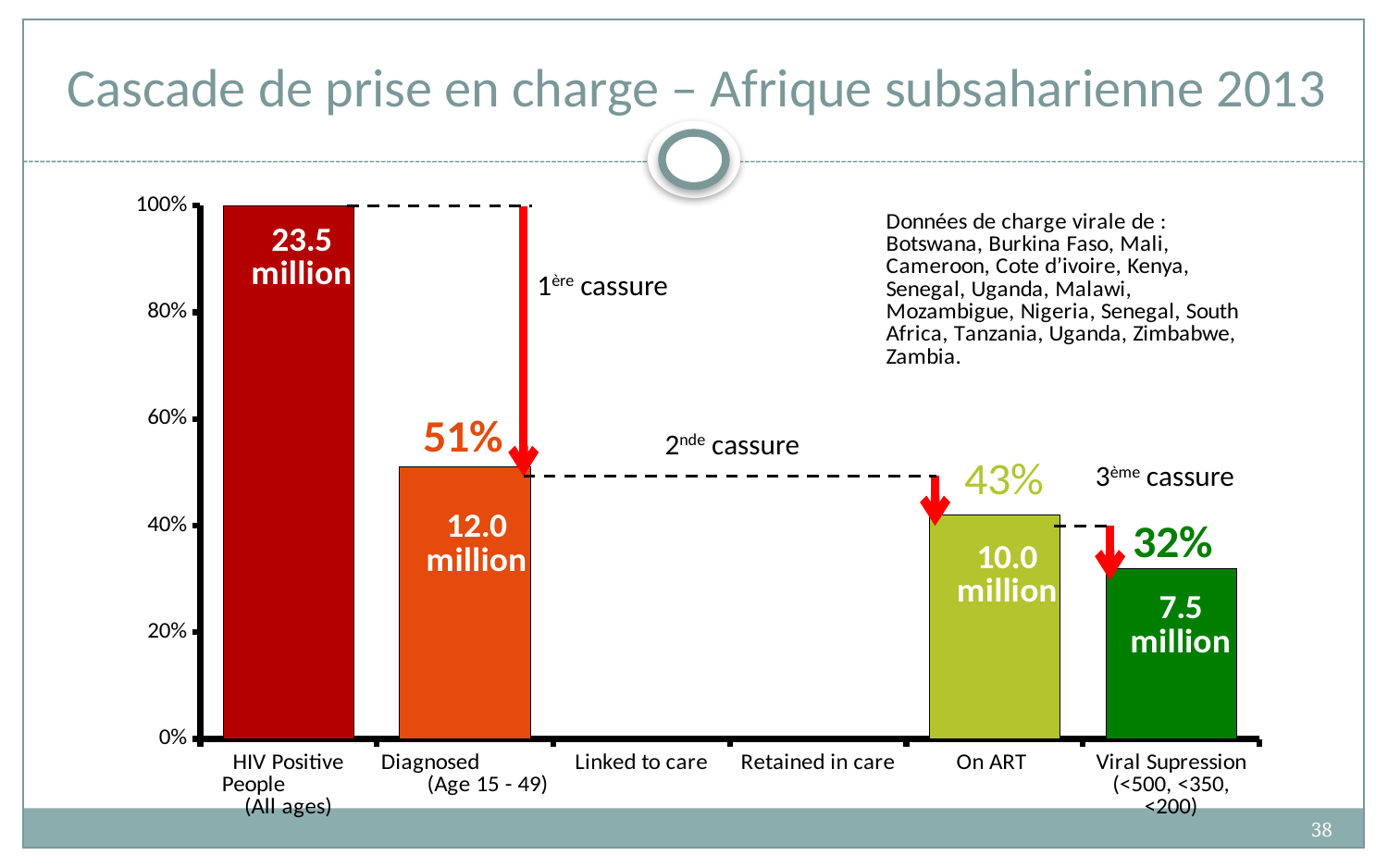
What percentage is shown for the Diagnosed (Age 15 - 49) bar? 51% How many million people are labelled on the Viral Supression bar? 7.5 million How many million people are labelled on the HIV Positive People (All ages) bar? 23.5 million What is the title of the slide containing the chart? Cascade de prise en charge – Afrique subsaharienne 2013 Which is larger, the On ART bar or the Viral Supression bar? On ART What is the difference in percentage points between the Diagnosed bar and the On ART bar? 8 Which category has the highest bar? HIV Positive People (All ages) Do the bar values rise or fall from left to right along the x axis? fall What percentage is shown for the Viral Supression bar? 32% Which category has the lowest bar? Viral Supression What kind of chart is shown on the slide? bar chart What percentage is shown for the On ART bar? 43%